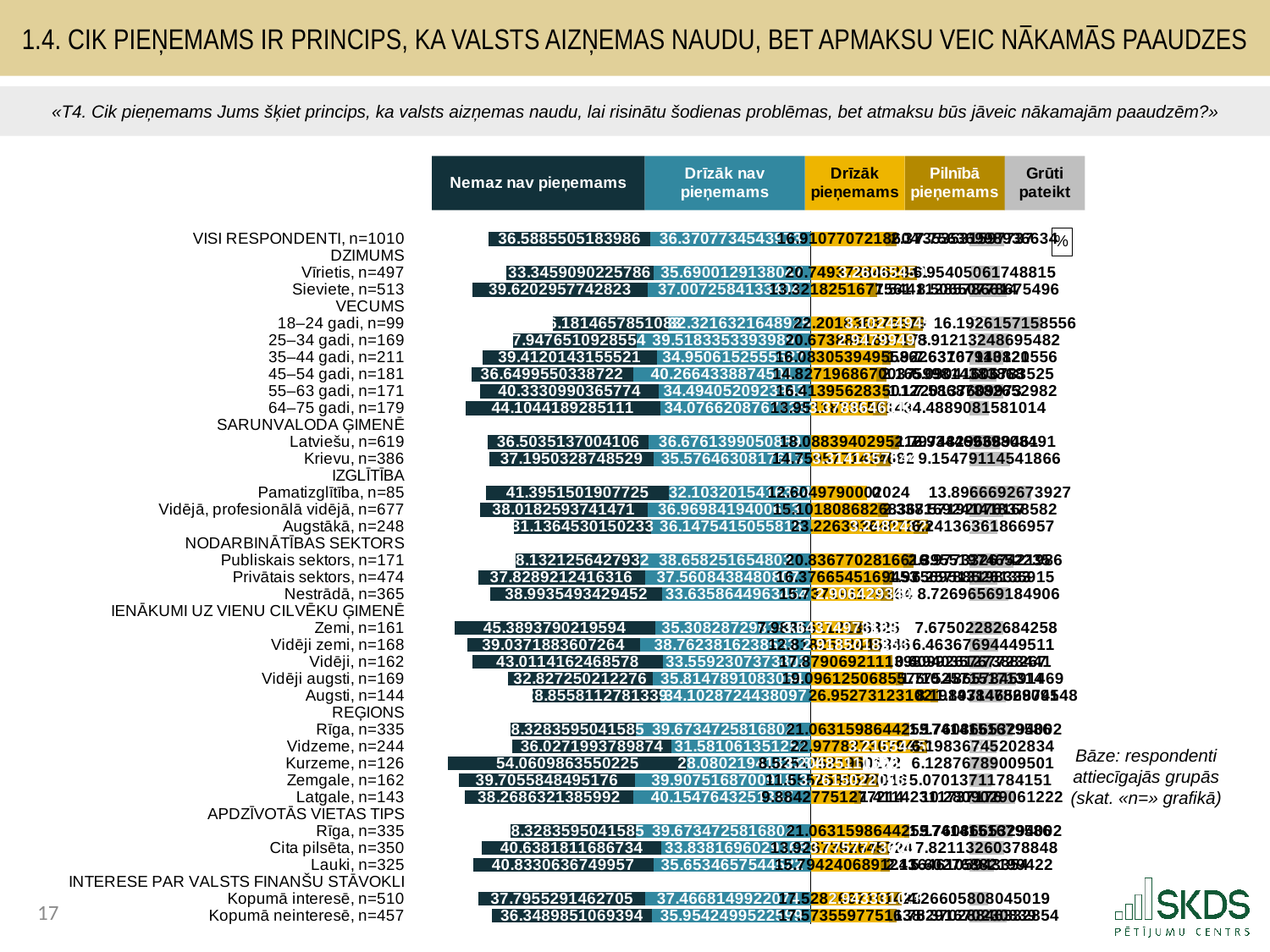
Among the REĢIONS groups, which has the highest value for "Nemaz nav pieņemams"? Kurzeme, n=126 Which has the larger "Nemaz nav pieņemams" value, Vīrietis, n=497 or Sieviete, n=513? Sieviete, n=513 Among the IENĀKUMI UZ VIENU CILVĒKU ĢIMENĒ groups, which has the highest value for "Nemaz nav pieņemams"? Zemi, n=161 Is the "Nemaz nav pieņemams" value for Kurzeme, n=126 greater or less than 50? greater What is the value of "Nemaz nav pieņemams" for VISI RESPONDENTI, n=1010? 36.5885505183986 What is the value of "Nemaz nav pieņemams" for Sieviete, n=513? 39.6202957742823 Which legend entry is shown in the darkest (navy) colour? Nemaz nav pieņemams How many series does the legend list? 5 What kind of chart is shown on the slide? Stacked horizontal bar chart What is the value of "Nemaz nav pieņemams" for Kurzeme, n=126? 54.0609863550225 What is the value of "Nemaz nav pieņemams" for 64–75 gadi, n=179? 44.1044189285111 What is the value of "Nemaz nav pieņemams" for Zemi, n=161? 45.3893790219594